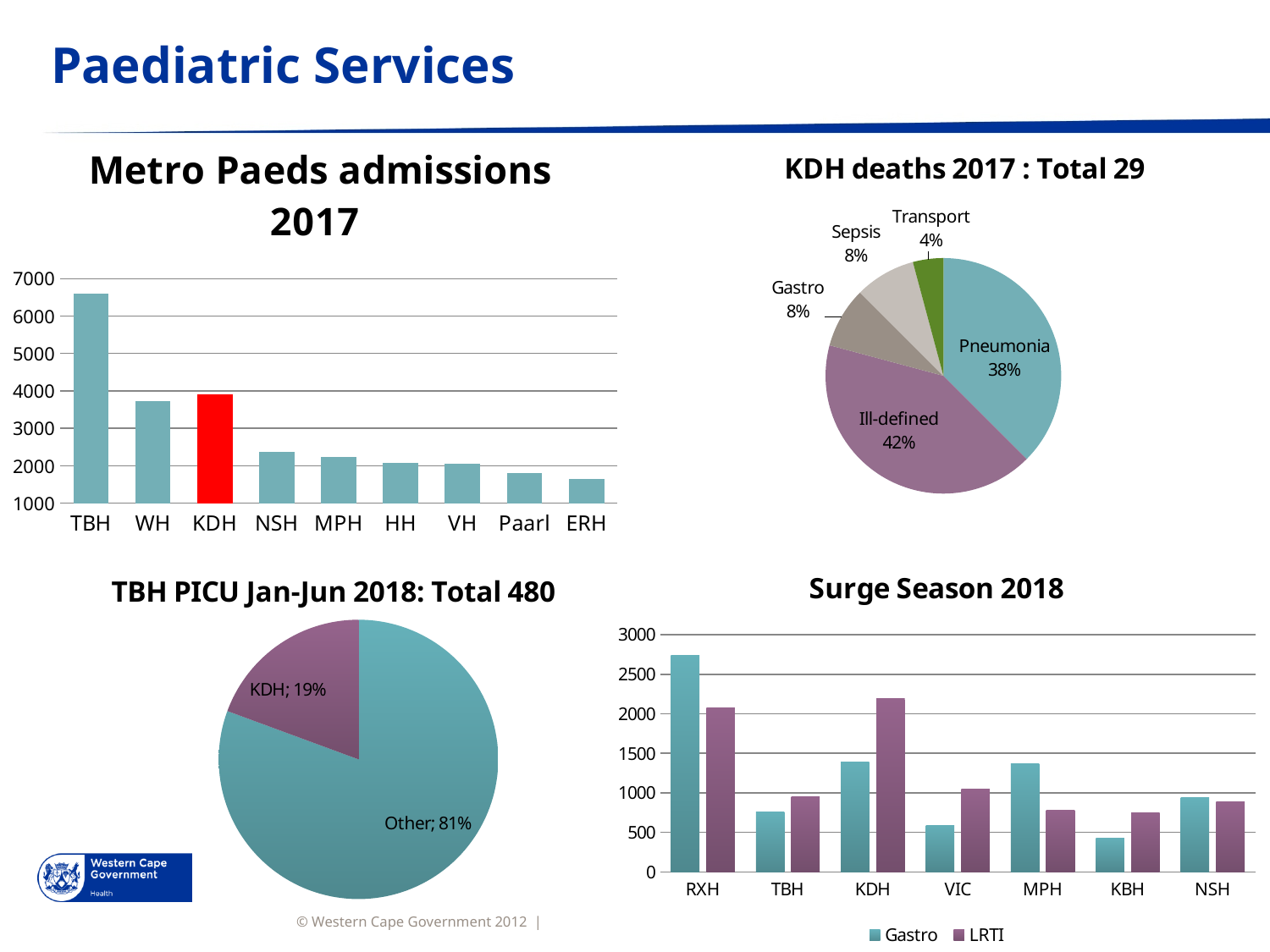
In the Surge Season 2018 chart, how many series does the legend list? 2 In the Metro Paeds admissions 2017 chart, how many hospitals are shown on the x axis? 9 In the Metro Paeds admissions 2017 chart, what kind of chart is shown? Bar chart In the Metro Paeds admissions 2017 chart, which bar is coloured red? KDH In the TBH PICU Jan-Jun 2018 pie chart, what share is KDH? 19% In the Surge Season 2018 chart, is the LRTI value for KDH greater or less than 2000? greater In the KDH deaths 2017 pie chart, what share of deaths is Pneumonia? 38% In the KDH deaths 2017 pie chart, what is the difference between the Ill-defined and Pneumonia shares? 4% In the Surge Season 2018 chart, which hospital has the highest Gastro value? RXH In the Metro Paeds admissions 2017 chart, which hospital has the highest admissions? TBH In the Metro Paeds admissions 2017 chart, is the value for TBH greater or less than 6000? greater In the KDH deaths 2017 pie chart, which cause has the largest share? Ill-defined